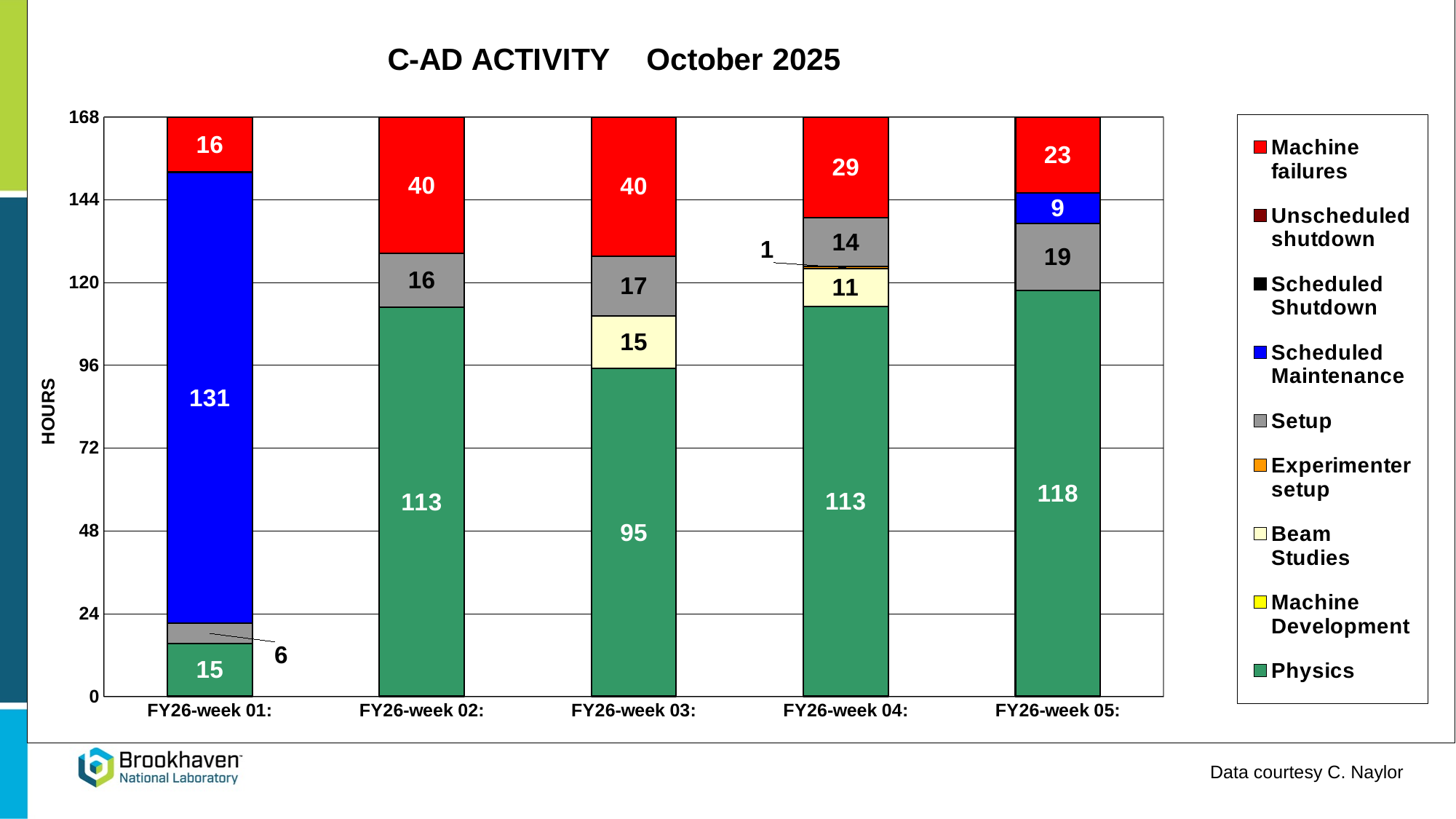
How many Physics hours are shown for FY26-week 02? 113 What is the Setup value for FY26-week 01? 6 Which week has the larger Setup value, FY26-week 03 or FY26-week 05? FY26-week 05: Which week has the highest Physics value? FY26-week 05: Which week has the lowest Physics value? FY26-week 01: How many weeks are shown on the x axis? 5 What is the difference between the Machine failures values for FY26-week 02 and FY26-week 05? 17 What is the Beam Studies value for FY26-week 03? 15 What is the Machine failures value for FY26-week 04? 29 What kind of chart is shown on the slide? Stacked bar chart How many hours of Scheduled Maintenance are shown for FY26-week 01? 131 How many series does the legend list? 9